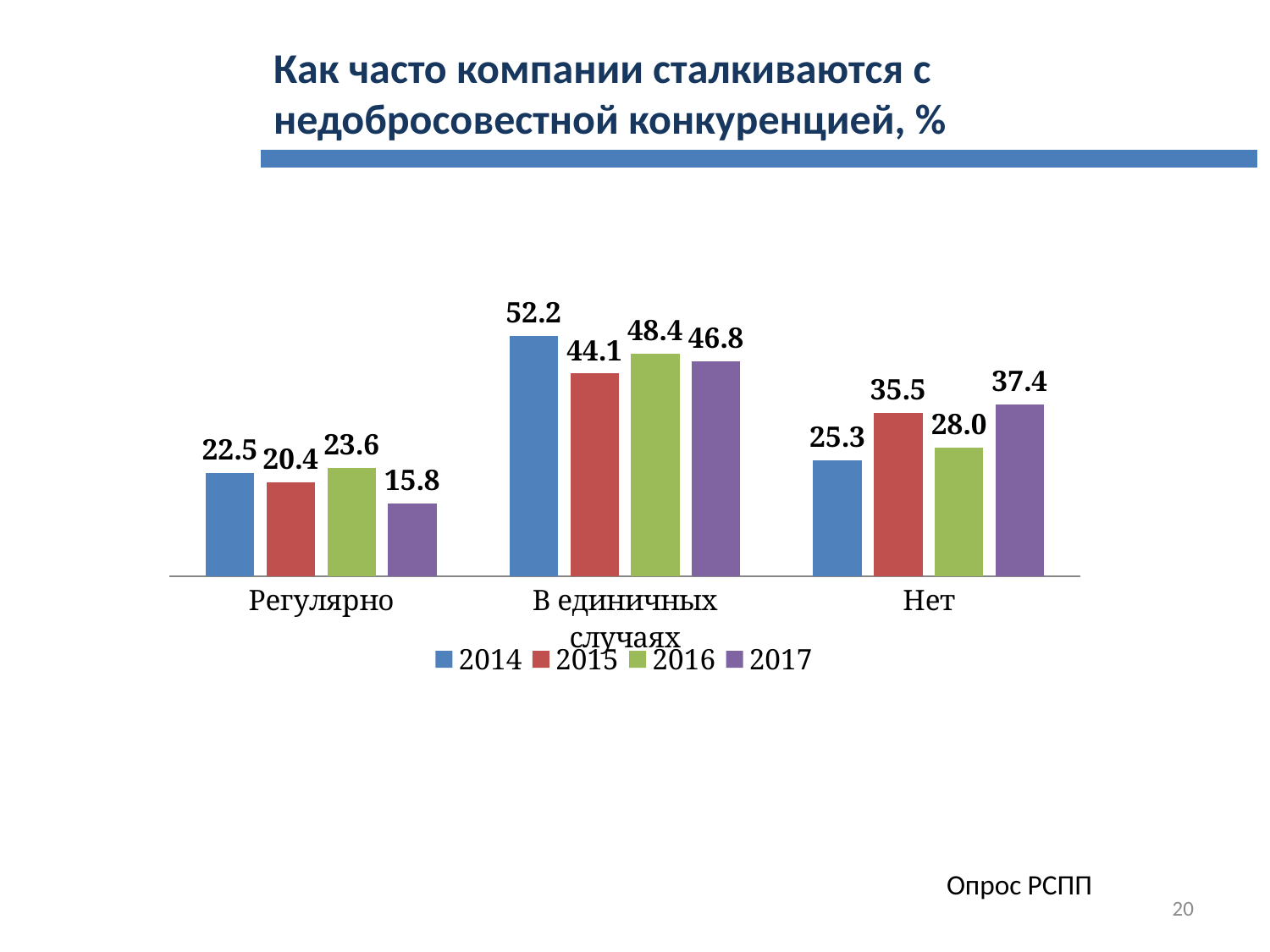
What is the value for 2014 in the "В единичных случаях" category? 52.2 Does the value for "Нет" rise or fall from 2016 to 2017? Rise What is the value for 2017 in the "Регулярно" category? 15.8 Which year has the highest value in the "Нет" category? 2017 What is the value for 2016 in the "Нет" category? 28.0 How many categories are shown on the x axis? 3 Which is larger: the 2015 value for "Нет" or the 2016 value for "Нет"? 2015 What kind of chart is shown on the slide? Bar chart What is the difference between the 2014 and 2015 values in the "В единичных случаях" category? 8.1 What is the title of the chart? Как часто компании сталкиваются с недобросовестной конкуренцией, % How many series does the legend list? 4 Which year has the lowest value in the "Регулярно" category? 2017